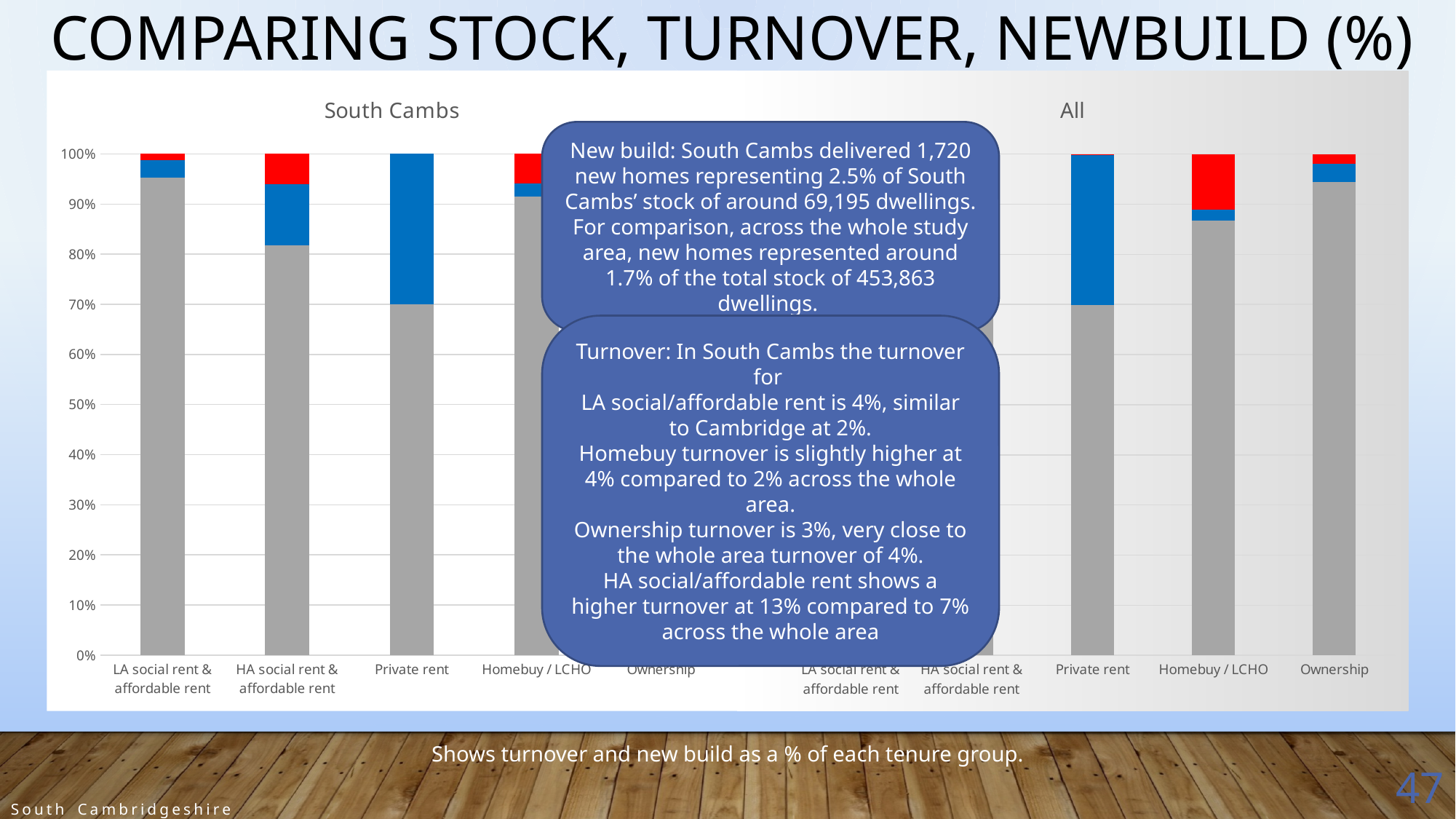
How many tenure categories are shown on the x axis of the South Cambs chart? 5 What is the title of the chart on the right side of the slide? All In the South Cambs chart, is the grey segment for Private rent greater or less than 80%? less What kind of chart is the South Cambs chart? Stacked bar chart In the South Cambs chart, which has the larger grey segment, LA social rent & affordable rent or Private rent? LA social rent & affordable rent In the South Cambs chart, is the grey segment for HA social rent & affordable rent greater or less than 90%? less In the All chart, is the grey segment for Private rent greater or less than 80%? less In the South Cambs chart, what is the total height of the Private rent stacked bar? 100% How many tenure categories are shown on the x axis of the All chart? 5 In the South Cambs chart, which has the larger blue segment, Private rent or HA social rent & affordable rent? Private rent